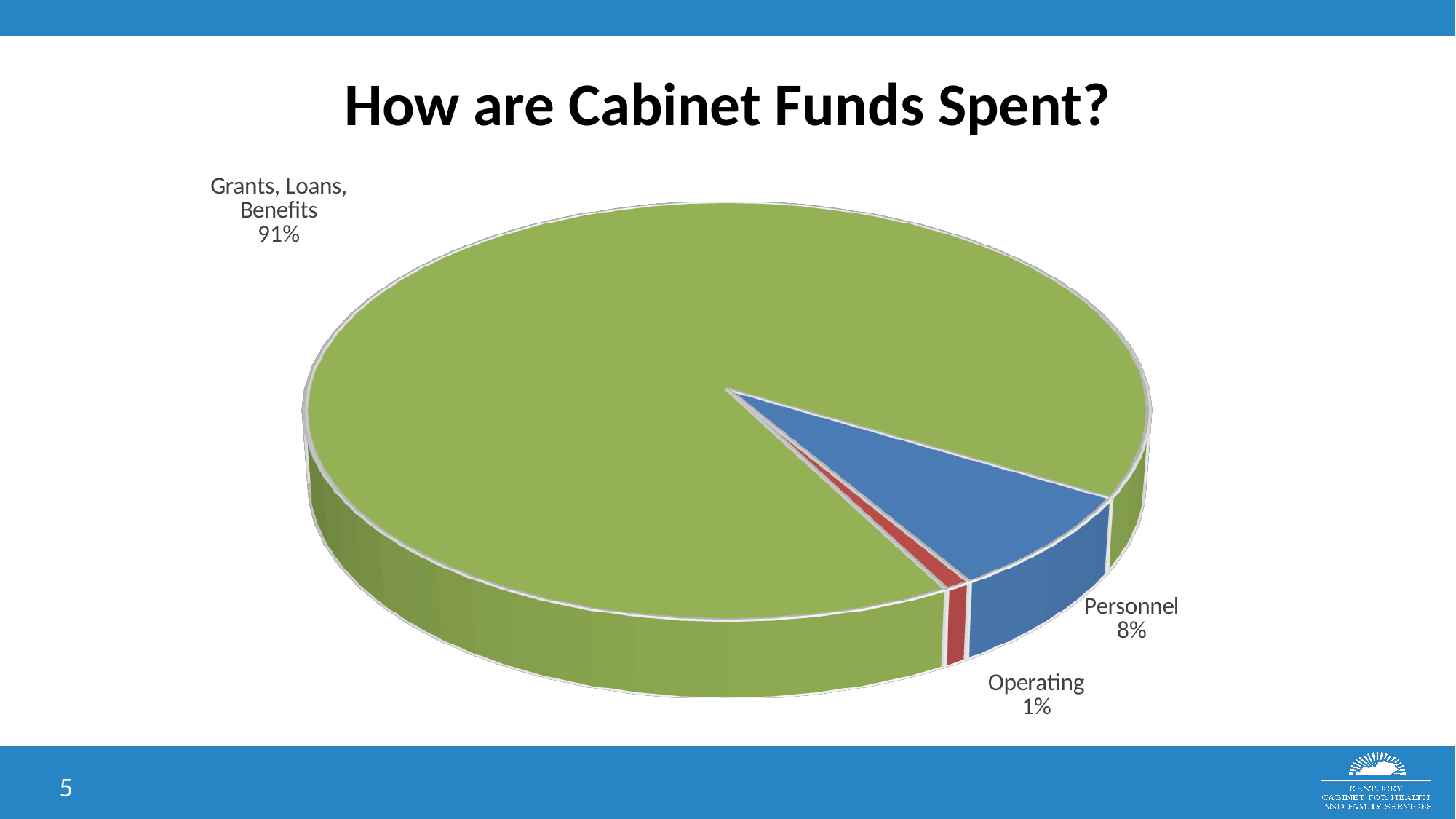
What is the difference in percentage points between the Grants, Loans, Benefits share and the Personnel share? 83 What share of Cabinet funds is spent on Personnel? 8% What kind of chart is shown on the slide? Pie chart What share of Cabinet funds is spent on Operating? 1% Which category accounts for the smallest share of Cabinet funds? Operating Which category accounts for the largest share of Cabinet funds? Grants, Loans, Benefits Which is larger, the share for Personnel or the share for Operating? Personnel What is the difference in percentage points between the Personnel share and the Operating share? 7 What share of Cabinet funds is spent on Grants, Loans, Benefits? 91% What is the title of the chart? How are Cabinet Funds Spent? How many categories are shown in the pie chart? 3 What colour is the Personnel slice of the pie chart? Blue